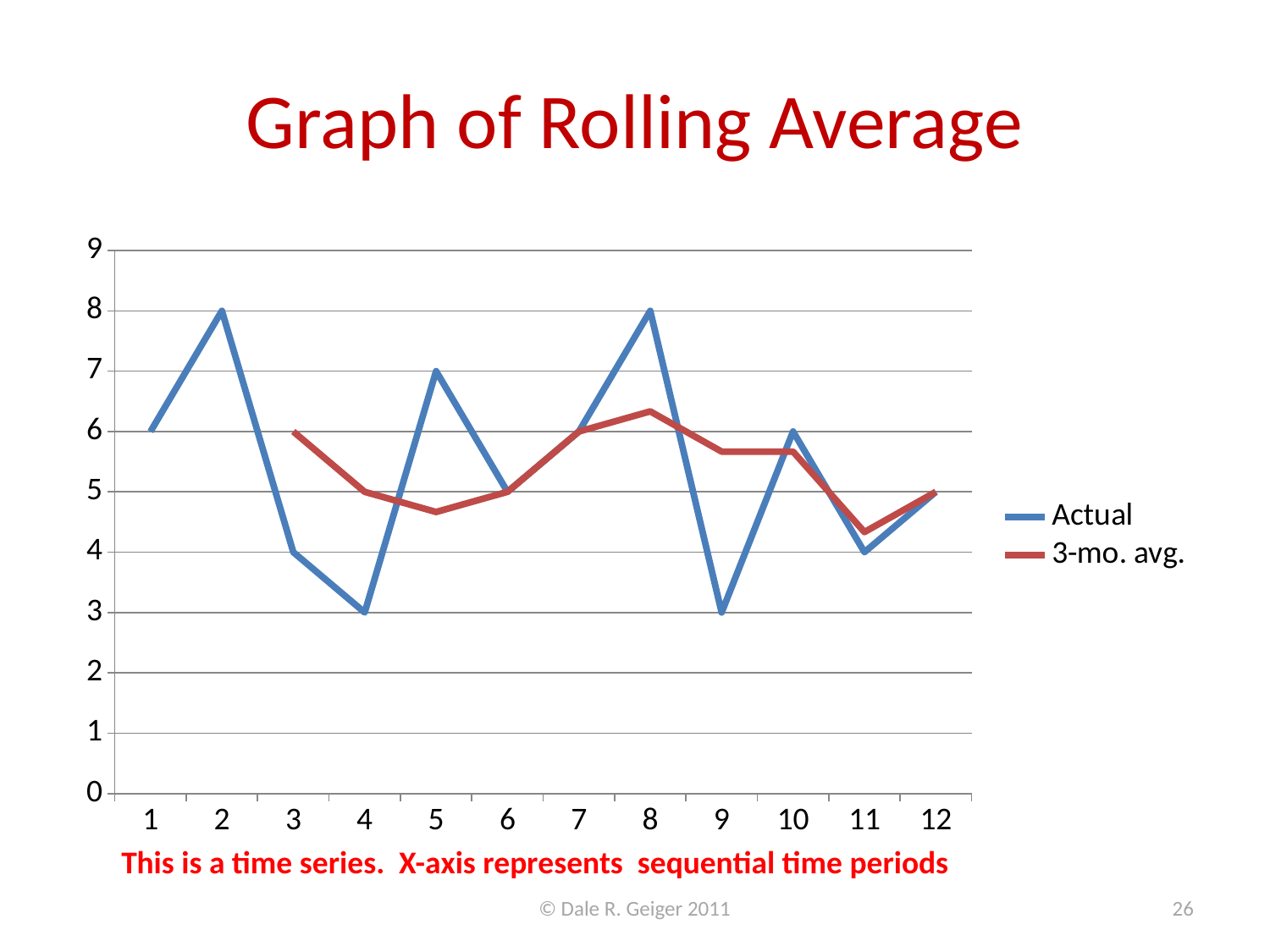
What is the title of the chart? Graph of Rolling Average What is the difference between the Actual value at period 2 and the Actual value at period 4? 5 Is the 3-mo. avg. value at period 8 greater or less than 6? greater Is the 3-mo. avg. value at period 11 greater or less than 5? less What is the 3-mo. avg. value at period 3? 6 How many time periods are plotted on the x-axis? 12 What is the Actual value at period 4? 3 What kind of chart is shown on the slide? Line chart What is the Actual value at period 2? 8 Does the Actual series rise or fall from period 8 to period 9? Fall How many series does the legend list? 2 Which period has the larger Actual value, period 5 or period 6? Period 5